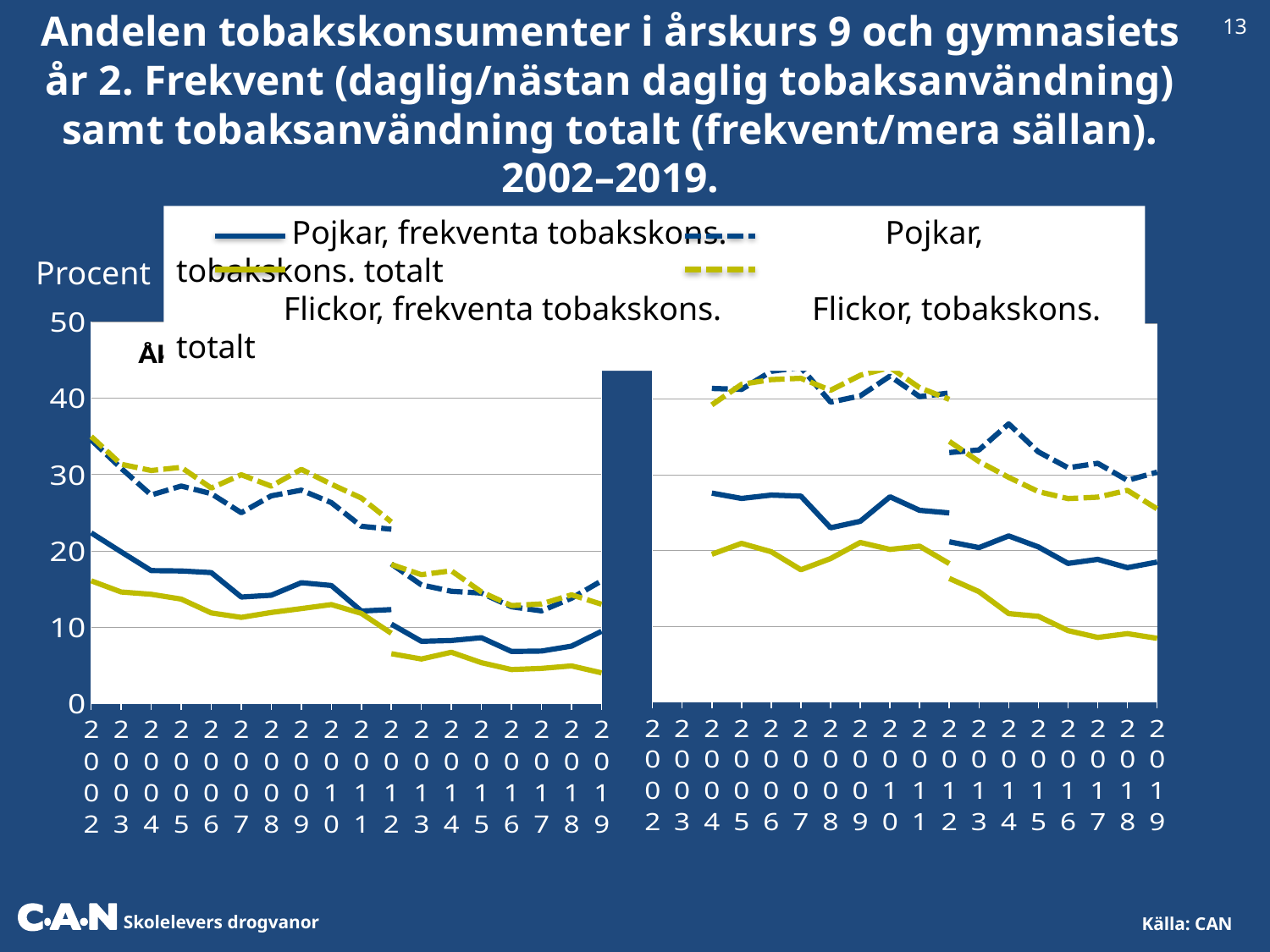
In the left panel (årskurs 9), which is larger in 2002: Pojkar, tobakskons. totalt or Pojkar, frekventa tobakskons.? Pojkar, tobakskons. totalt In the right panel (gymnasiets år 2), is the value for Flickor, frekventa tobakskons. in 2019 greater or less than 10? less In the left panel (årskurs 9), does Flickor, frekventa tobakskons. rise or fall from 2002 to 2019? Fall What kind of chart is shown on the slide? Line chart In the left panel (årskurs 9), is the value for Pojkar, tobakskons. totalt in 2002 greater or less than 30? greater What is the label on the vertical axis? Procent In the left panel (årskurs 9), is the value for Flickor, frekventa tobakskons. in 2019 greater or less than 10? less How many series does the legend list? 4 In the right panel (gymnasiets år 2), which is larger in 2019: Pojkar, frekventa tobakskons. or Flickor, frekventa tobakskons.? Pojkar, frekventa tobakskons. Which series is drawn as a solid yellow line? Flickor, frekventa tobakskons. How many years are plotted along the x axis of the left panel (årskurs 9)? 18